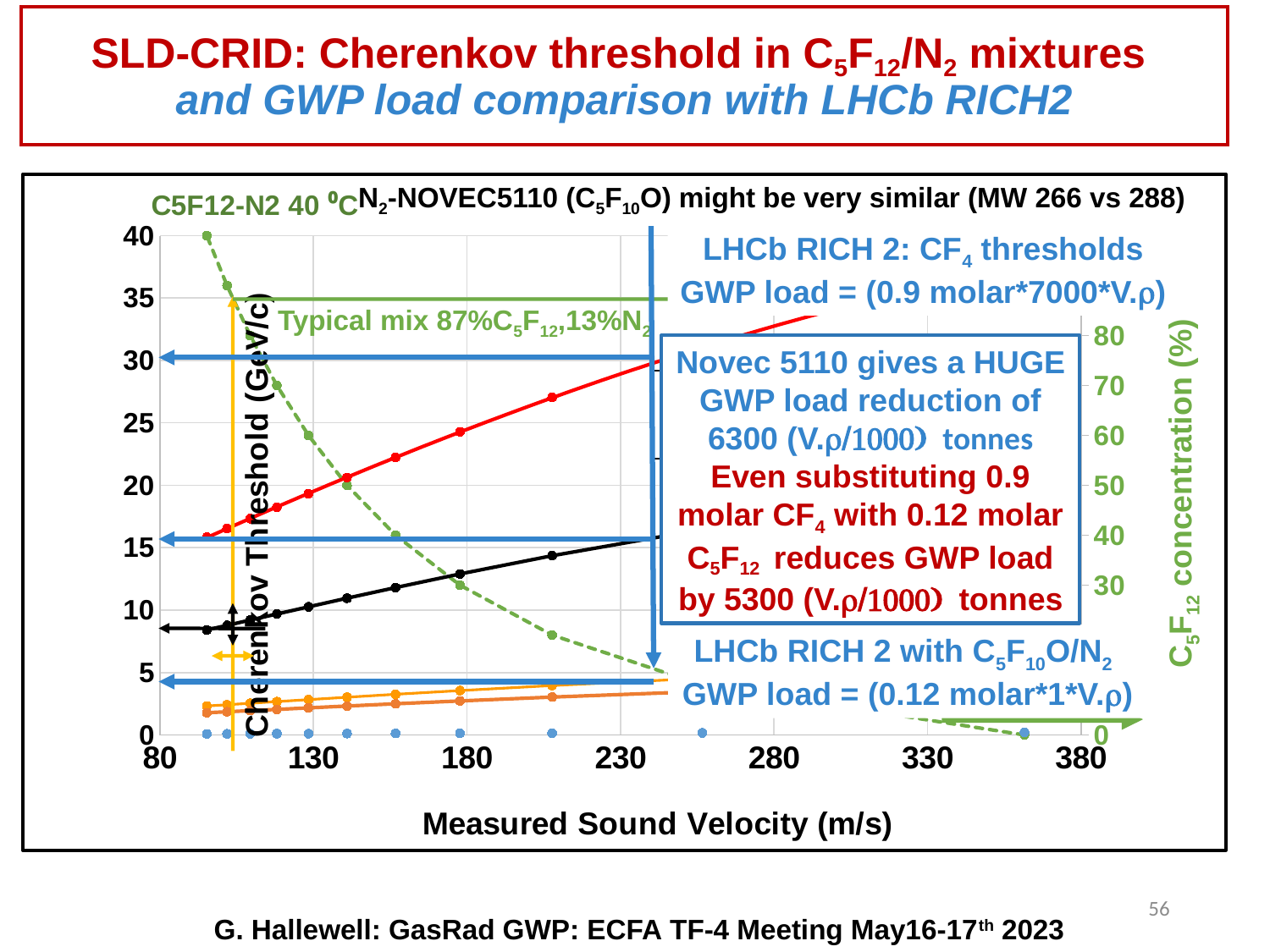
Does the green dashed line rise or fall as the measured sound velocity increases? fall Is the value of the black line at a sound velocity of 230 m/s greater or less than 20 GeV/c? less Is the value of the black line at a sound velocity of 100 m/s greater or less than 10 GeV/c? less Which solid line reaches the highest Cherenkov threshold on the chart? red line What is the title of the x axis of the chart? Measured Sound Velocity (m/s) Is the value of the red line at a sound velocity of 230 m/s greater or less than 25 GeV/c? greater Does the black line rise or fall as the measured sound velocity increases? rise At a sound velocity of 230 m/s, which line has the higher Cherenkov threshold, the red line or the black line? red line What kind of chart is shown on the slide? line chart What is the title of the left y axis of the chart? Cherenkov Threshold (GeV/c) Does the red line rise or fall as the measured sound velocity increases? rise